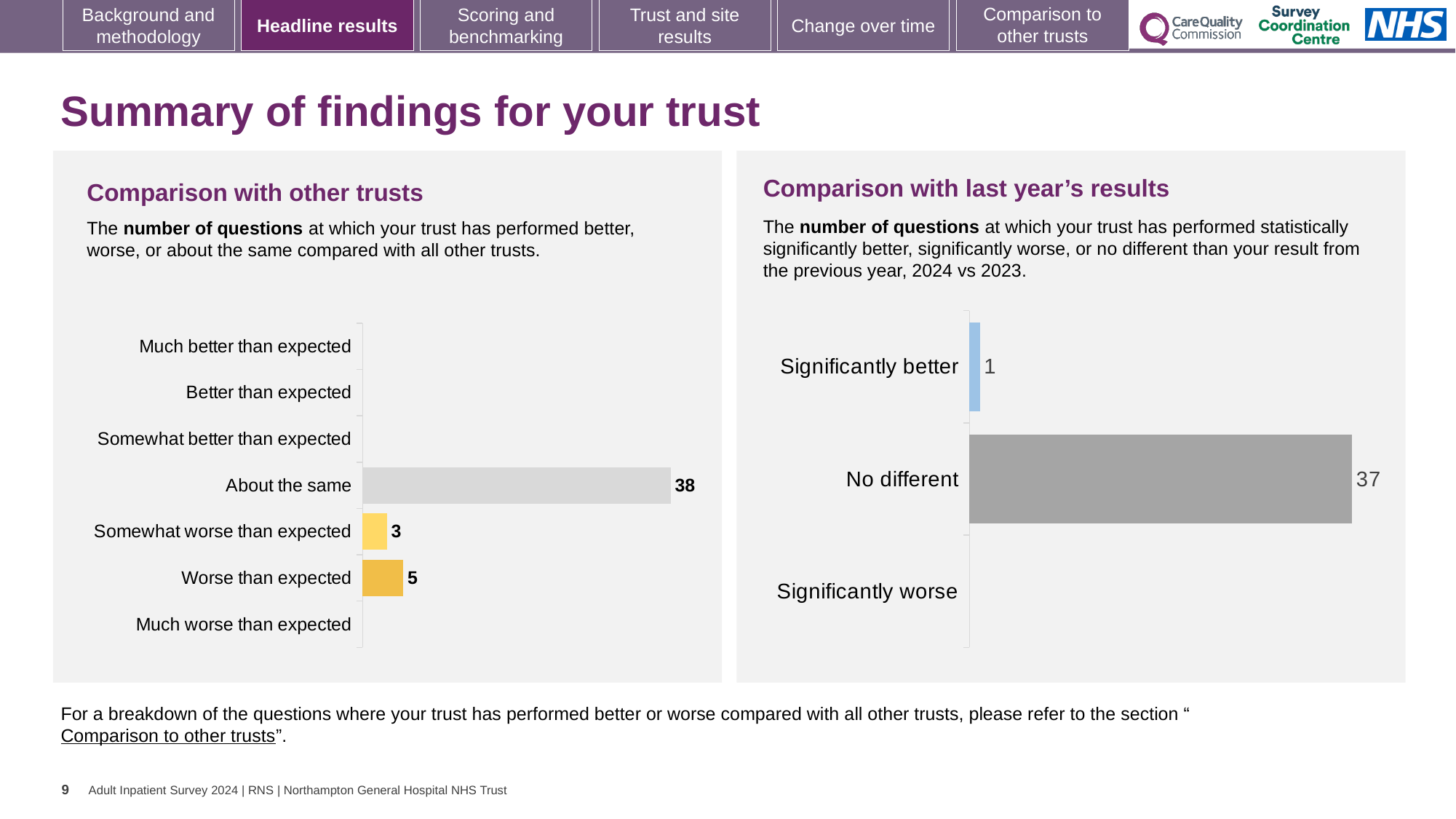
In the 'Comparison with other trusts' chart, which is larger: 'Worse than expected' or 'Somewhat worse than expected'? Worse than expected How many categories are listed on the 'Comparison with last year's results' chart? 3 In the 'Comparison with other trusts' chart, how many questions are 'About the same'? 38 In the 'Comparison with other trusts' chart, how many questions are 'Somewhat worse than expected'? 3 In the 'Comparison with other trusts' chart, which category has the highest value? About the same In the 'Comparison with last year's results' chart, how many questions are 'No different'? 37 In the 'Comparison with last year's results' chart, what is the difference between 'No different' and 'Significantly better'? 36 In the 'Comparison with other trusts' chart, what is the difference between 'About the same' and 'Worse than expected'? 33 What type of chart is the 'Comparison with other trusts' chart? Bar chart In the 'Comparison with last year's results' chart, how many questions are 'Significantly better'? 1 In the 'Comparison with other trusts' chart, how many questions are 'Worse than expected'? 5 How many categories are listed on the 'Comparison with other trusts' chart? 7